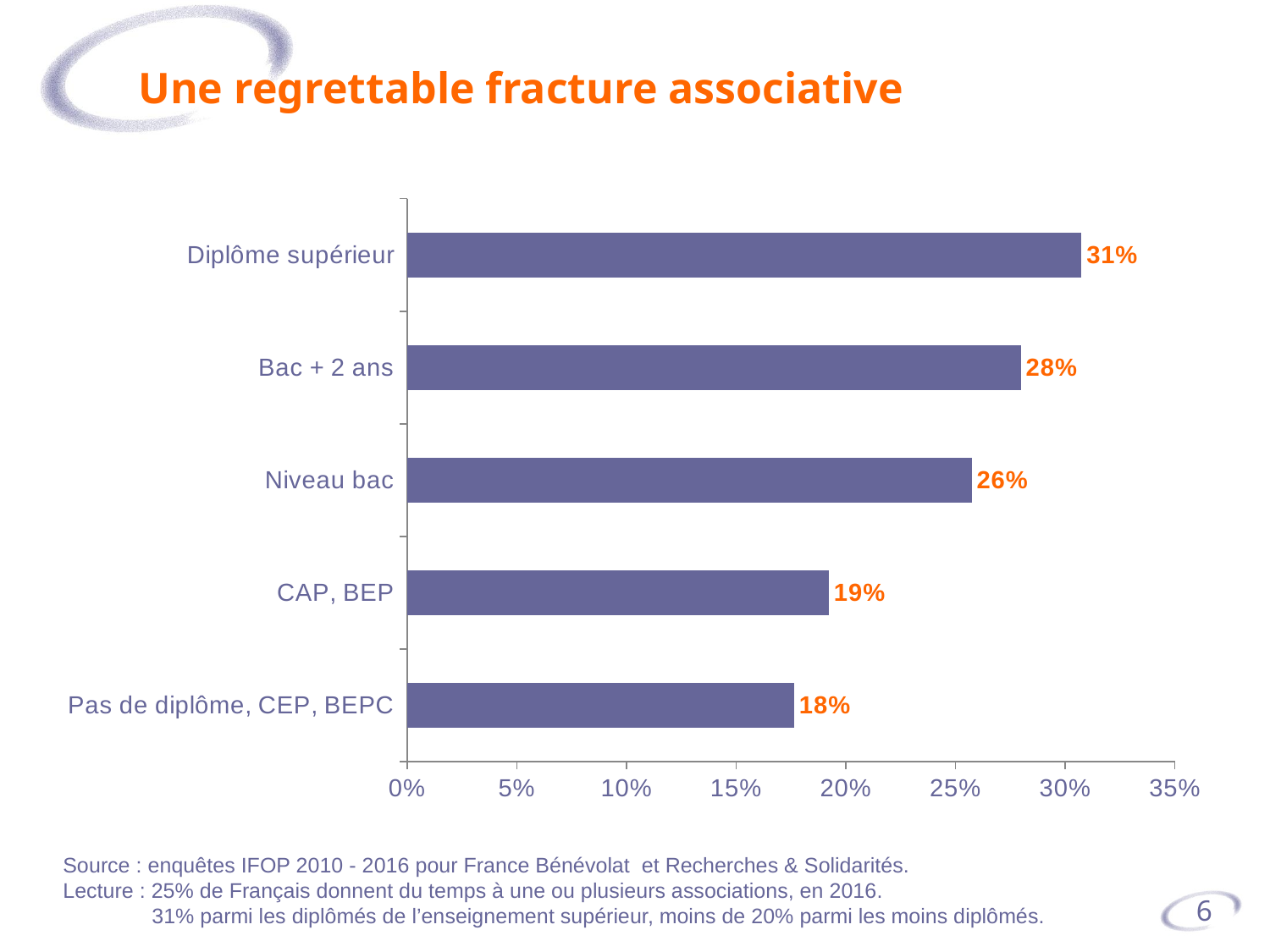
Which category has the lowest value? Pas de diplôme, CEP, BEPC What is the value for Pas de diplôme, CEP, BEPC? 18% How many categories are shown in the chart? 5 What is the difference between the values for Bac + 2 ans and CAP, BEP? 9% What kind of chart is shown on the slide? Bar chart What is the difference between the values for Diplôme supérieur and Pas de diplôme, CEP, BEPC? 13% Which category has the highest value? Diplôme supérieur What is the value for CAP, BEP? 19% What is the value for Niveau bac? 26% What is the value for Diplôme supérieur? 31% What is the value for Bac + 2 ans? 28% Which is larger, the value for Niveau bac or the value for CAP, BEP? Niveau bac